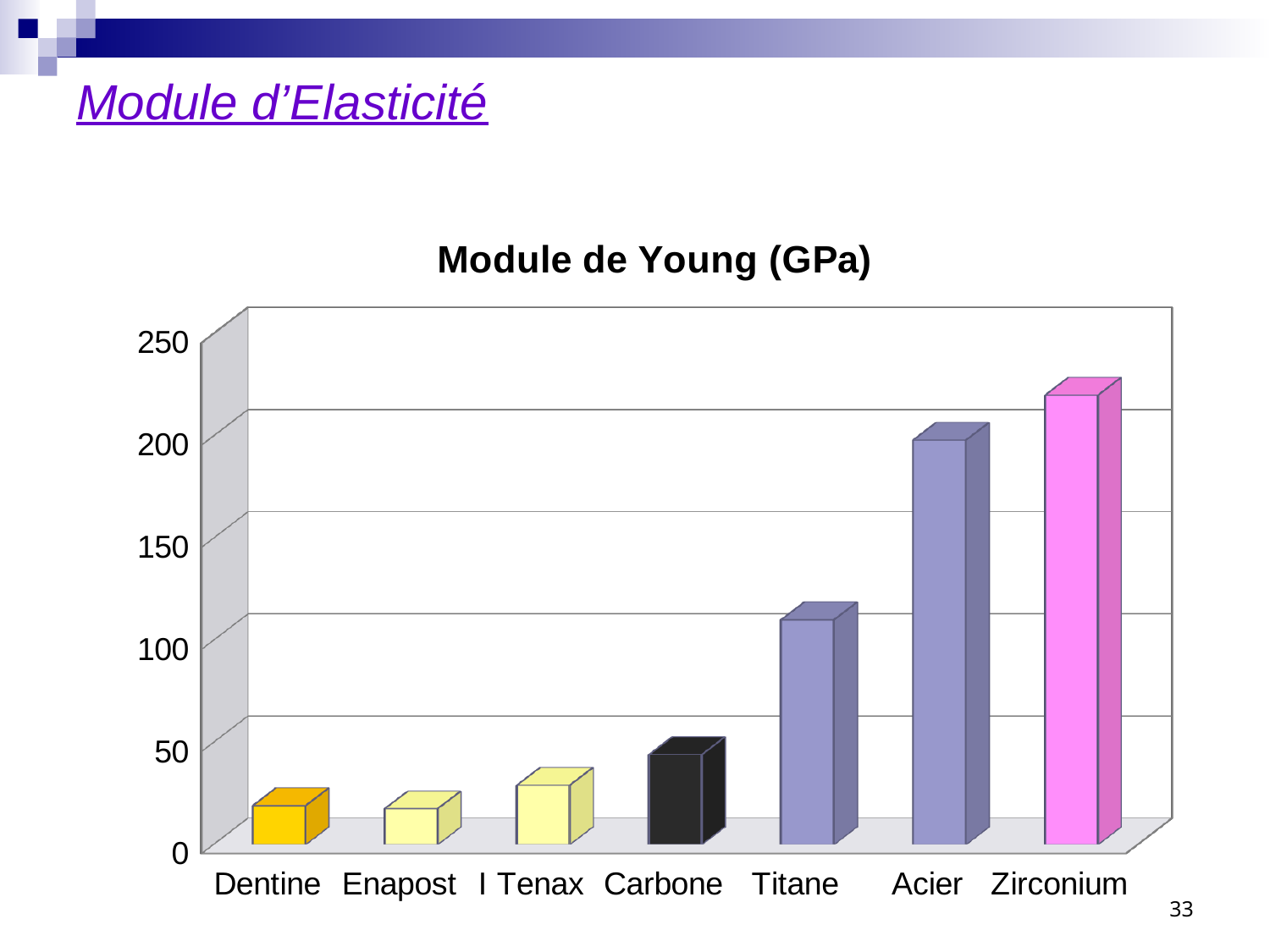
Is the value for Acier greater or less than 250? less Do the values generally rise or fall from left to right along the x axis? rise How many categories are shown on the x axis of the chart? 7 Which category has the highest value in the chart? Zirconium Which has a larger value, Carbone or I Tenax? Carbone Is the value for Zirconium greater or less than 200? greater Which has a larger value, Acier or Titane? Acier Is the value for Titane greater or less than 150? less What type of chart is shown on the slide? bar chart What is the title of the chart? Module de Young (GPa)